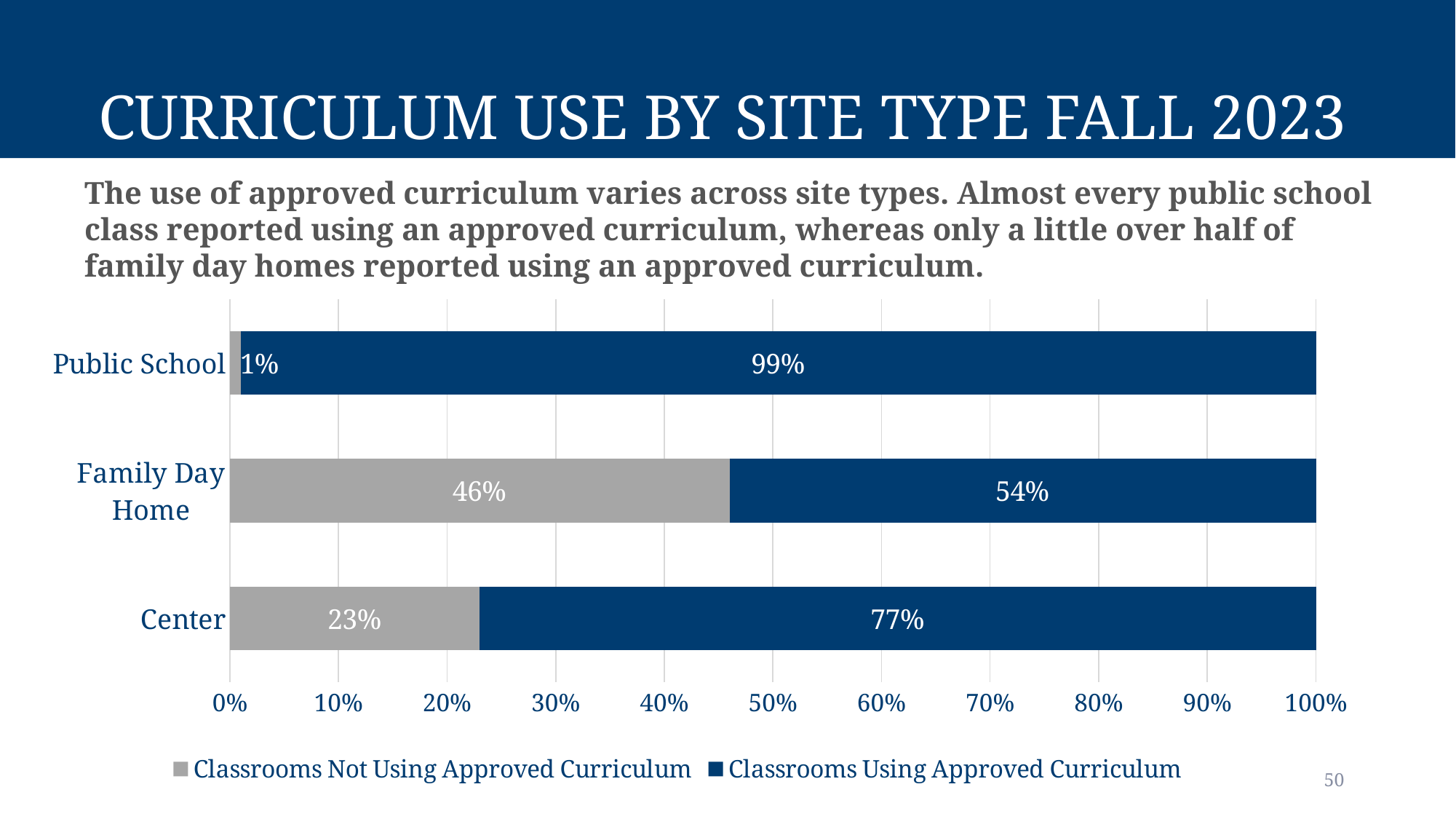
What is the difference between the percentage of Center classrooms using an approved curriculum and Family Day Home classrooms using an approved curriculum? 23% Which colour represents Classrooms Not Using Approved Curriculum in the chart? Gray Which site type has the highest percentage of classrooms using an approved curriculum? Public School What kind of chart is shown on the slide? Stacked bar chart How many site types are shown in the chart? 3 How many series does the legend list? 2 What percentage of Center classrooms are using an approved curriculum? 77% Which is larger: the percentage of Center classrooms not using an approved curriculum or the percentage of Family Day Home classrooms not using an approved curriculum? Family Day Home What percentage of Family Day Home classrooms are not using an approved curriculum? 46% What percentage of Public School classrooms are using an approved curriculum? 99% What is the total of the stacked bar for Family Day Home? 100% Which site type has the lowest percentage of classrooms using an approved curriculum? Family Day Home